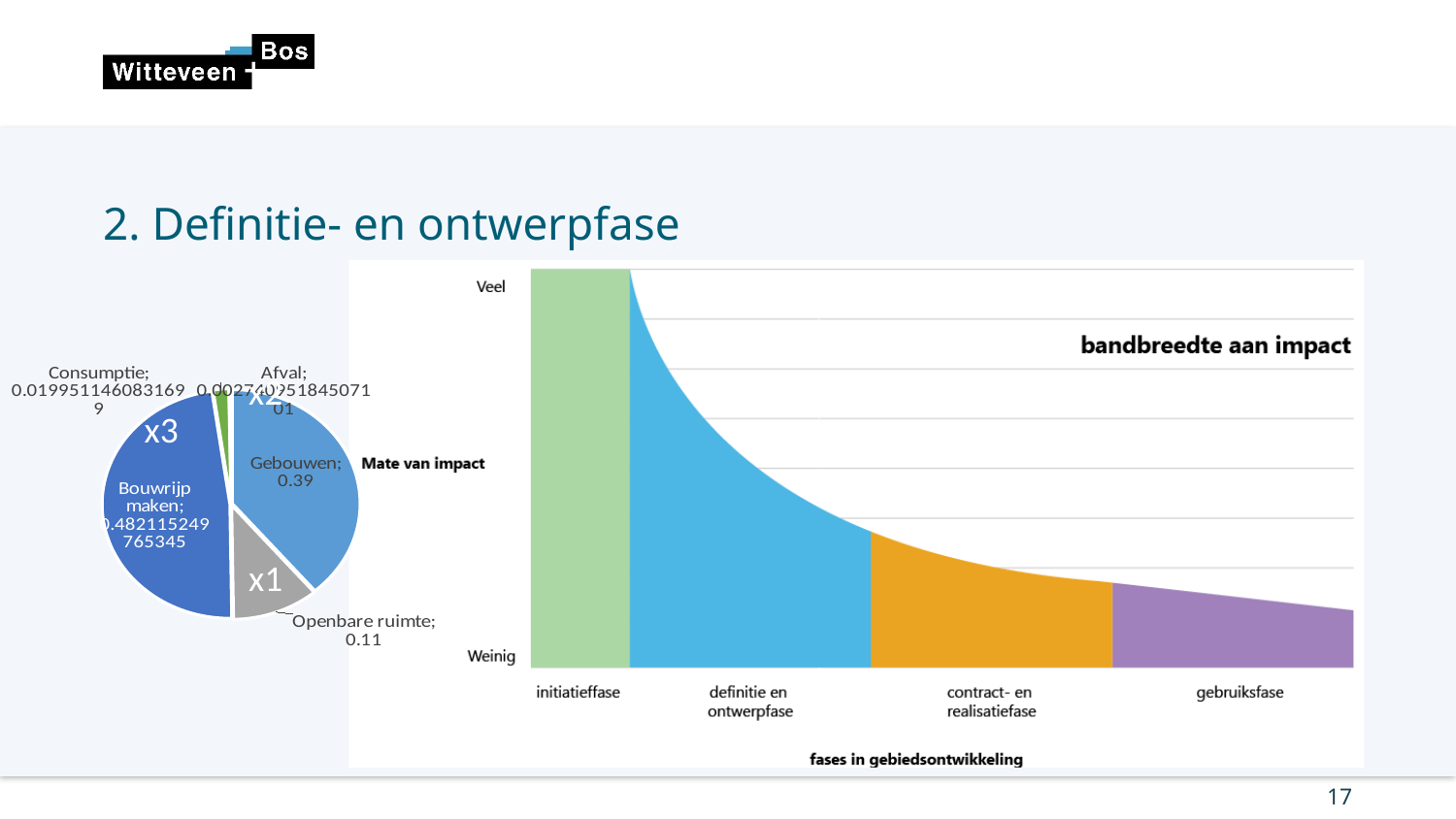
In the pie chart on the left, which category has the smallest slice? Afval In the pie chart on the left, what is the value for Gebouwen? 0.39 In the chart on the right, does the level of impact rise or fall from initiatieffase to gebruiksfase? fall In the pie chart on the left, what is the value for Openbare ruimte? 0.11 In the chart on the right, how many phases are shown along the x axis? 4 In the pie chart on the left, what is the difference between the values for Gebouwen and Openbare ruimte? 0.28 How many categories does the pie chart on the left have? 5 In the pie chart on the left, which is larger, Gebouwen or Openbare ruimte? Gebouwen In the pie chart on the left, which multiplier label is placed on the Bouwrijp maken slice? x3 In the pie chart on the left, which category has the largest slice? Bouwrijp maken What kind of chart is shown on the left side of the slide? pie chart What is the x-axis title of the chart on the right? fases in gebiedsontwikkeling